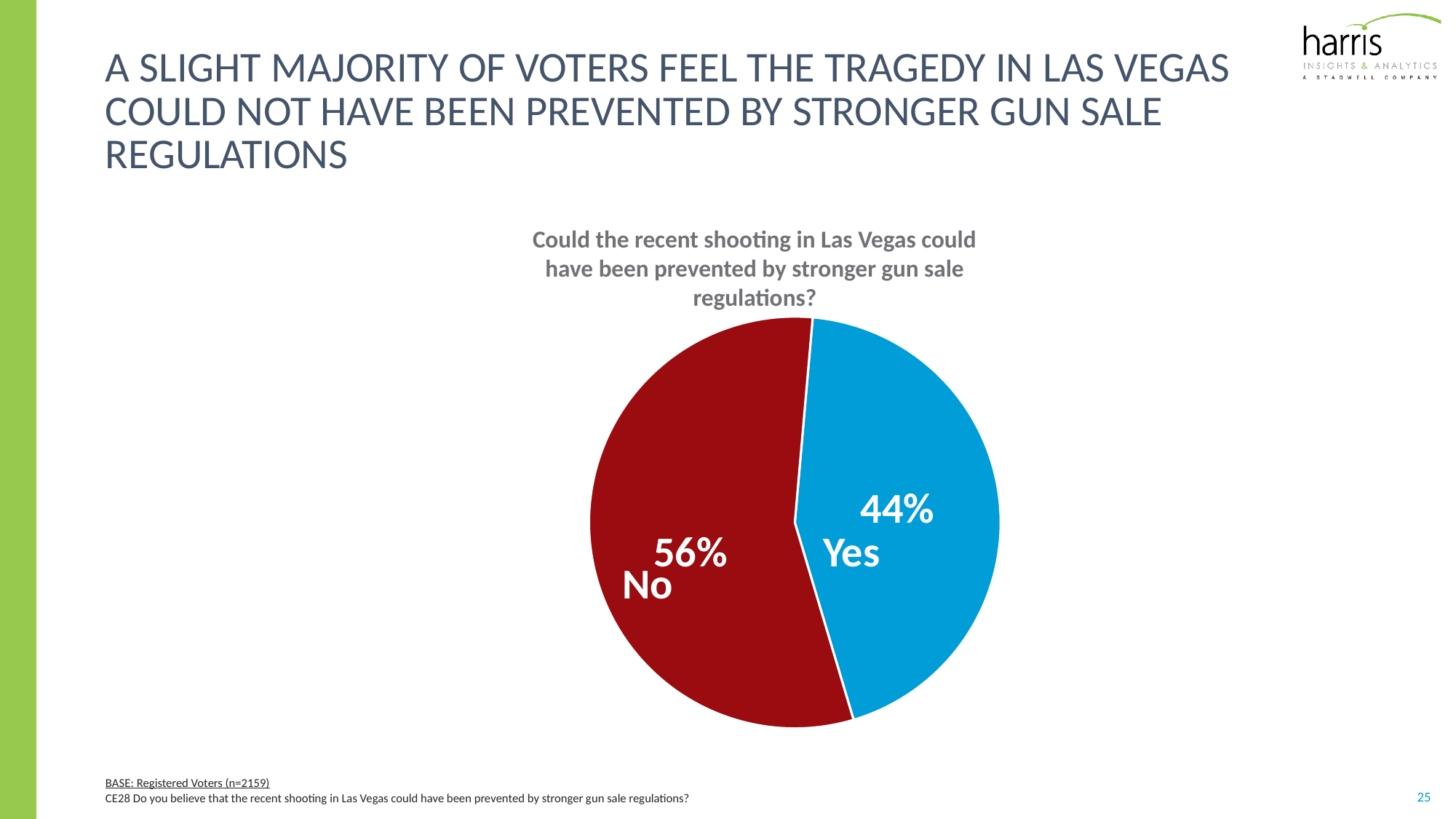
What colour is the "Yes" slice of the pie chart? Blue What kind of chart is shown on the slide? Pie chart How many slices does the pie chart have? 2 What is the combined total of the Yes and No slices? 100% Which response has the largest slice in the pie chart? No Which response has the larger share of the pie: Yes or No? No What percentage of voters answered "No" to whether the Las Vegas shooting could have been prevented by stronger gun sale regulations? 56% Which response has the smallest slice in the pie chart? Yes What percentage of voters answered "Yes" in the pie chart? 44% What colour is the "No" slice of the pie chart? Red What is the difference in percentage points between the No and Yes slices? 12